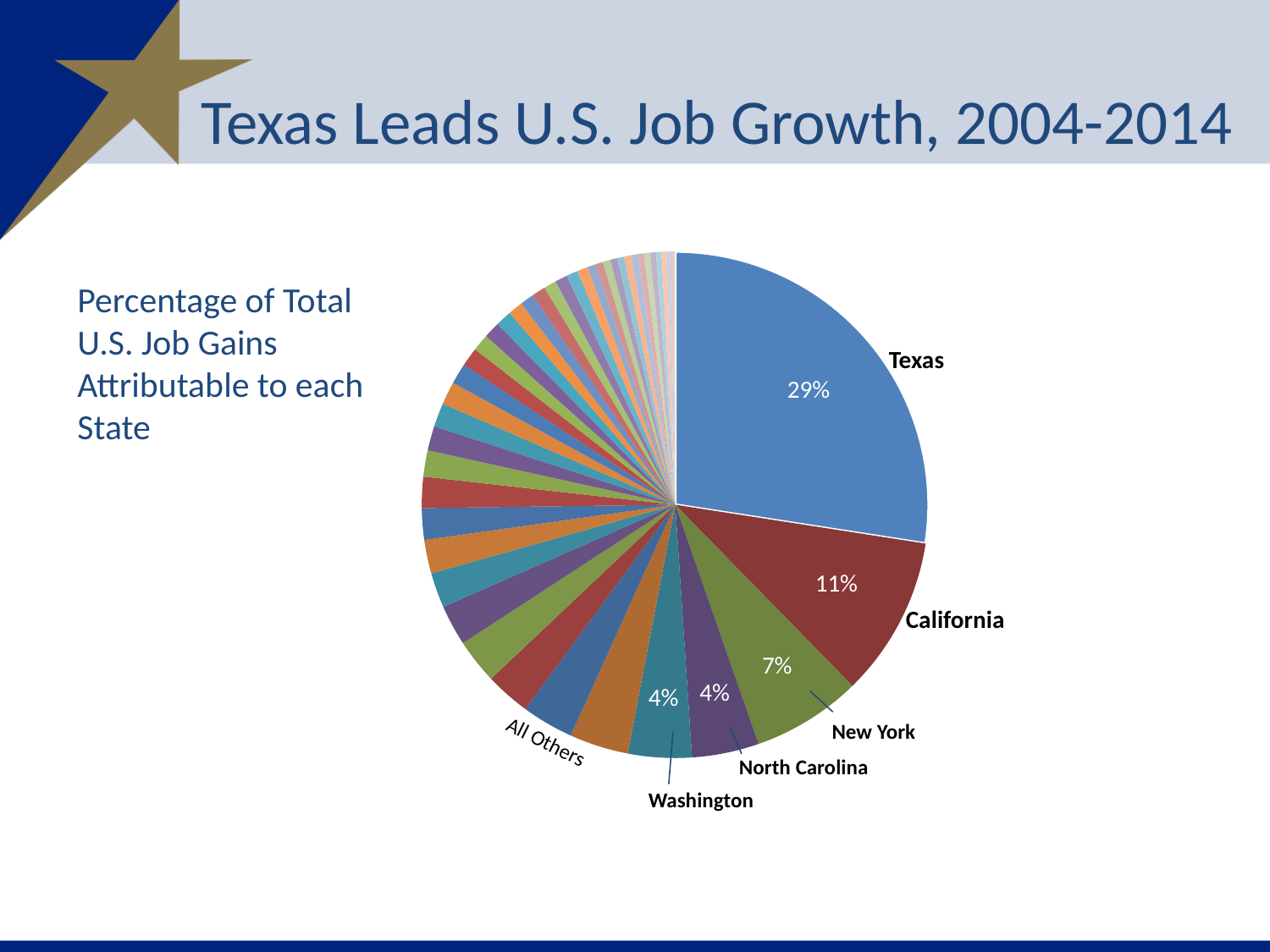
What kind of chart is shown on the slide? pie chart What percentage of total U.S. job gains is attributable to Washington? 4% Which state has the largest slice of the pie? Texas What percentage of total U.S. job gains is attributable to North Carolina? 4% What percentage of total U.S. job gains is attributable to New York? 7% How many percentage points larger is Texas's share than California's? 18 How many percentage points larger is California's share than New York's? 4 What percentage of total U.S. job gains is attributable to California? 11% What label is given to the group of many small slices on the left side of the pie? All Others What is the title of the slide? Texas Leads U.S. Job Growth, 2004-2014 Which has a larger share of U.S. job gains, California or New York? California What percentage of total U.S. job gains is attributable to Texas? 29%